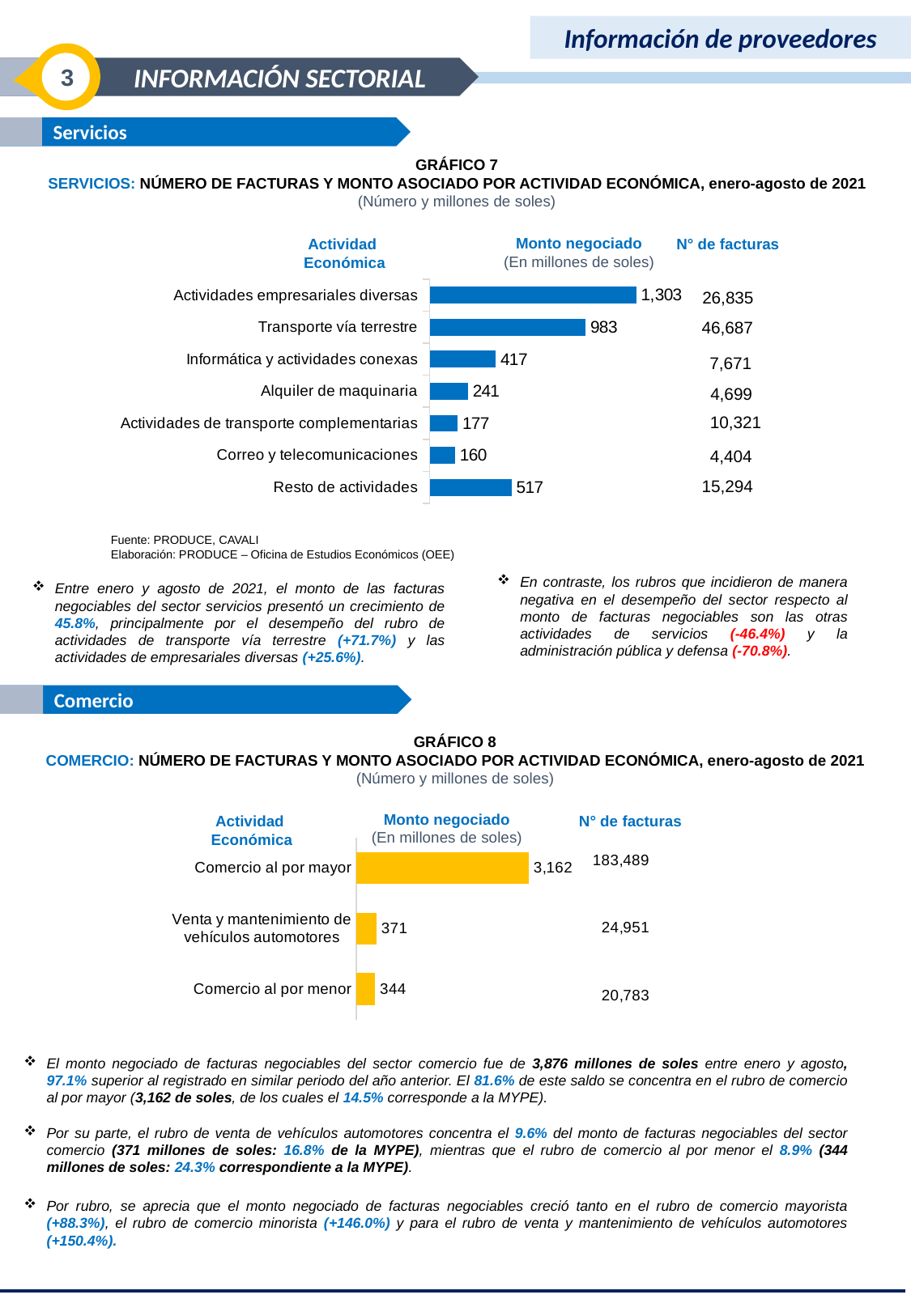
In Gráfico 8 (Comercio), what is the monto negociado for Comercio al por mayor? 3,162 In Gráfico 7 (Servicios), what is the difference in monto negociado between Actividades empresariales diversas and Transporte vía terrestre? 320 In Gráfico 7 (Servicios), which actividad económica has the highest monto negociado? Actividades empresariales diversas In Gráfico 7 (Servicios), what is the monto negociado for Transporte vía terrestre? 983 What type of chart is Gráfico 8 (Comercio)? Bar chart In Gráfico 8 (Comercio), what is the N° de facturas for Comercio al por mayor? 183,489 In Gráfico 7 (Servicios), how many actividades económicas are plotted? 7 In Gráfico 8 (Comercio), which actividad económica has the lowest monto negociado? Comercio al por menor In Gráfico 8 (Comercio), what is the difference in monto negociado between Venta y mantenimiento de vehículos automotores and Comercio al por menor? 27 In Gráfico 7 (Servicios), which has a larger monto negociado: Informática y actividades conexas or Resto de actividades? Resto de actividades In Gráfico 7 (Servicios), what is the N° de facturas for Transporte vía terrestre? 46,687 In Gráfico 7 (Servicios), which actividad económica has the lowest monto negociado? Correo y telecomunicaciones